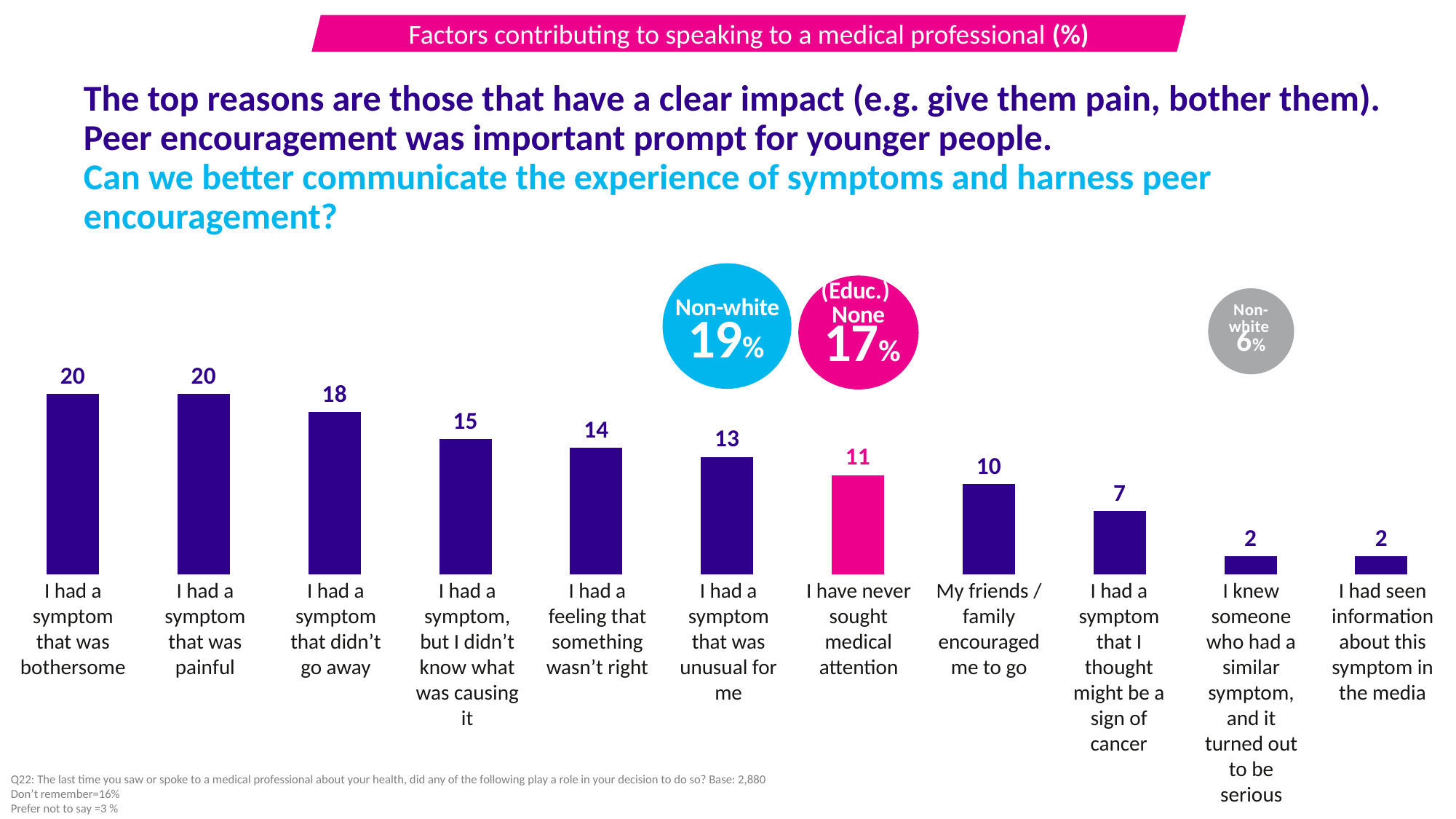
Which bar is coloured pink rather than purple? I have never sought medical attention What kind of chart is shown on the slide? Bar chart Do the values rise or fall from left to right across the chart? Fall What is the difference between 'I had a symptom that was bothersome' and 'I had a feeling that something wasn't right'? 6 What is the value for 'I had a symptom that didn't go away'? 18 Which category has the lowest value? I knew someone who had a similar symptom, and it turned out to be serious; I had seen information about this symptom in the media (both 2) Which is larger: 'I had a symptom that was unusual for me' or 'I had a symptom, but I didn't know what was causing it'? I had a symptom, but I didn't know what was causing it What is the value for 'My friends / family encouraged me to go'? 10 What is the title of the chart? Factors contributing to speaking to a medical professional (%) What is the value for 'I had a symptom that I thought might be a sign of cancer'? 7 How many categories are shown in the chart? 11 What is the value for 'I have never sought medical attention'? 11